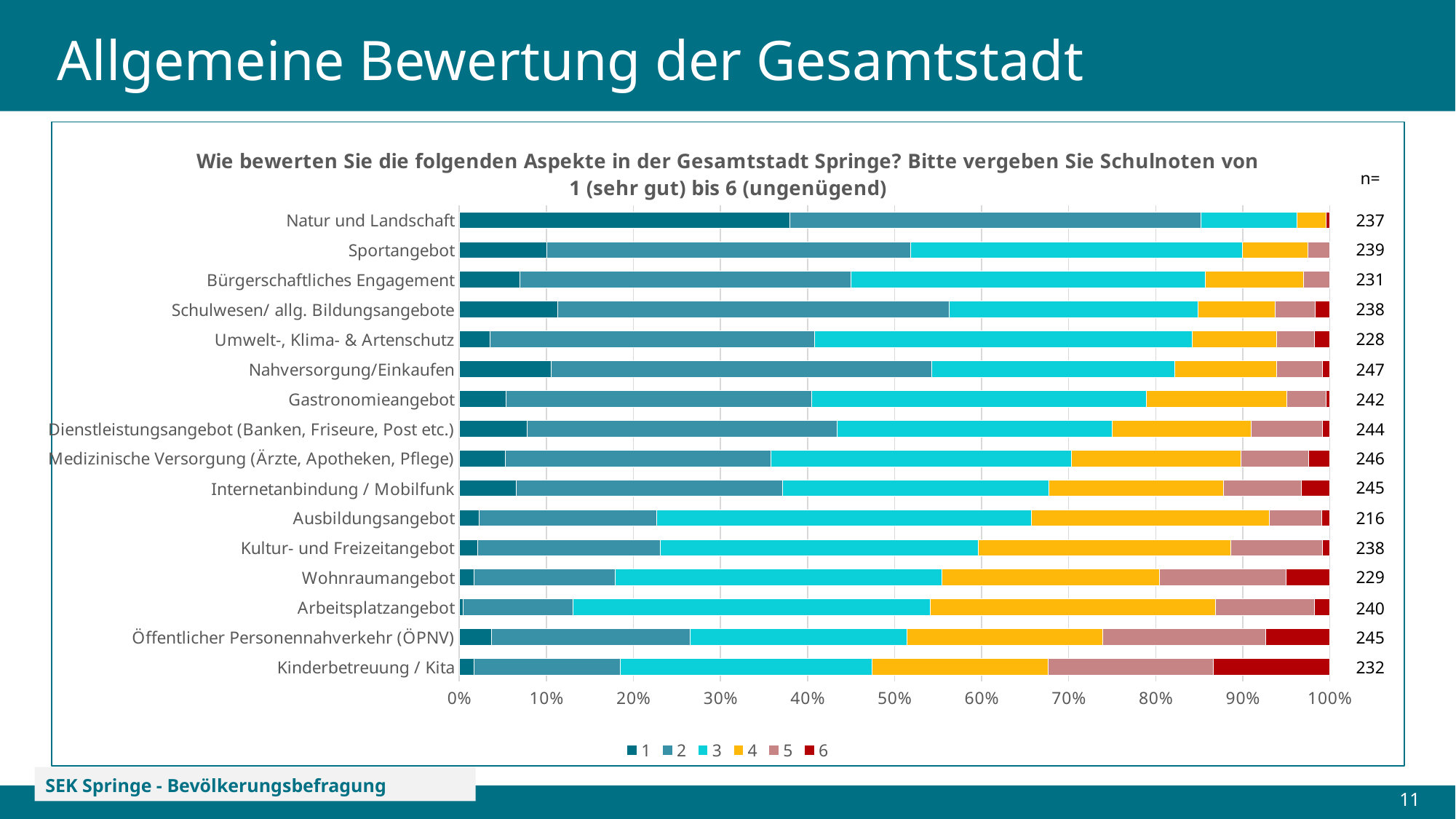
How many series does the legend list? 6 Which aspect has the lowest n= value? Ausbildungsangebot What is the n= value for Ausbildungsangebot? 216 How many aspects (categories) are listed in the chart? 16 Which aspect has the highest n= value? Nahversorgung/Einkaufen Which aspect has the largest share of grade 1 (dark teal segment)? Natur und Landschaft Is the share of grade 1 for Natur und Landschaft greater or less than 30%? greater Which aspect has the largest share of grade 6 (dark red segment)? Kinderbetreuung / Kita What is the difference between the n= values of Nahversorgung/Einkaufen and Ausbildungsangebot? 31 What kind of chart is shown on the slide? Stacked bar chart What is the n= value for Natur und Landschaft? 237 What is the n= value for Kinderbetreuung / Kita? 232